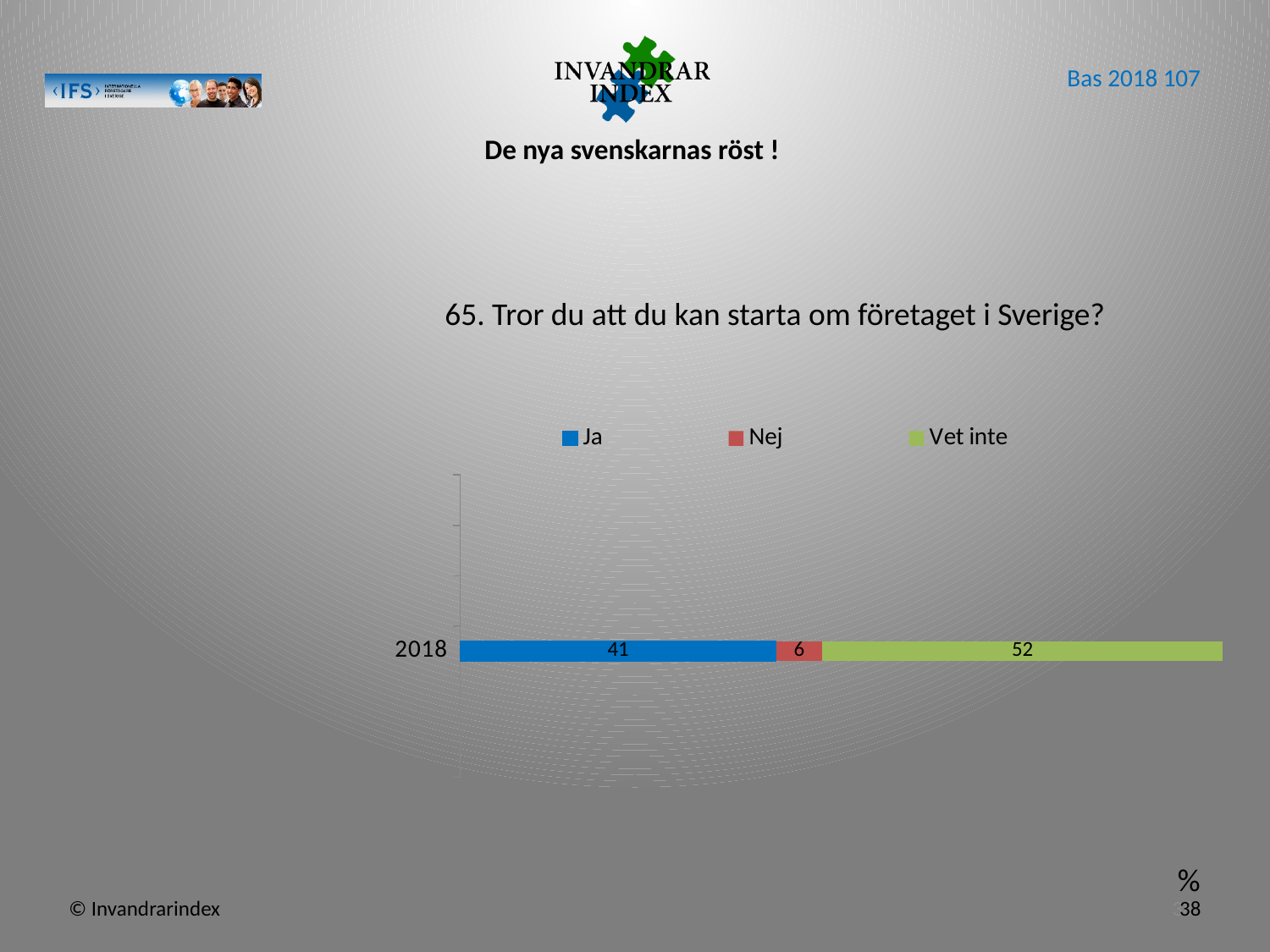
How many categories are shown on the chart? 1 What is the value for Ja in 2018? 41 Which is larger in 2018, Ja or Nej? Ja How many series does the legend list? 3 What is the title of the chart? 65. Tror du att du kan starta om företaget i Sverige? What is the total of the stacked bar for 2018? 99 What is the value for Vet inte in 2018? 52 What kind of chart is shown? Stacked bar chart What is the difference between the Vet inte and Ja values in 2018? 11 What is the value for Nej in 2018? 6 Which series has the highest value in 2018? Vet inte Which series has the lowest value in 2018? Nej